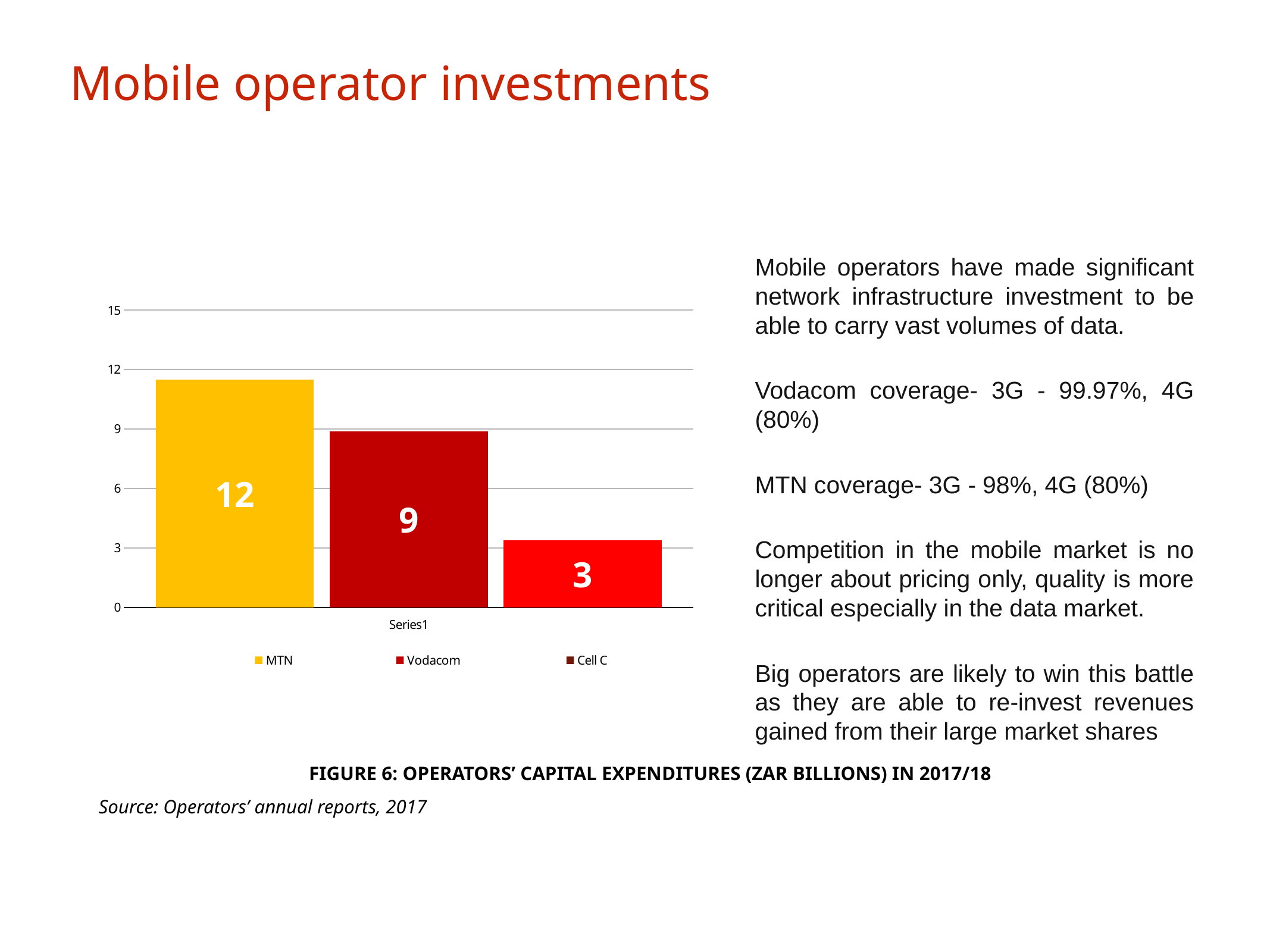
How many operators are shown in the chart? 3 Which operator has the lowest capital expenditure in the chart? Cell C What is the capital expenditure value shown for Cell C? 3 How many entries does the legend list? 3 Which is larger, the value for Vodacom or the value for Cell C? Vodacom What is the difference between the labelled values for Vodacom and Cell C? 6 What kind of chart is shown on the slide? Bar chart What colour is the bar for MTN? Yellow What is the capital expenditure value shown for Vodacom? 9 What is the difference between the labelled values for MTN and Vodacom? 3 Which operator has the highest capital expenditure in the chart? MTN What is the capital expenditure value shown for MTN? 12